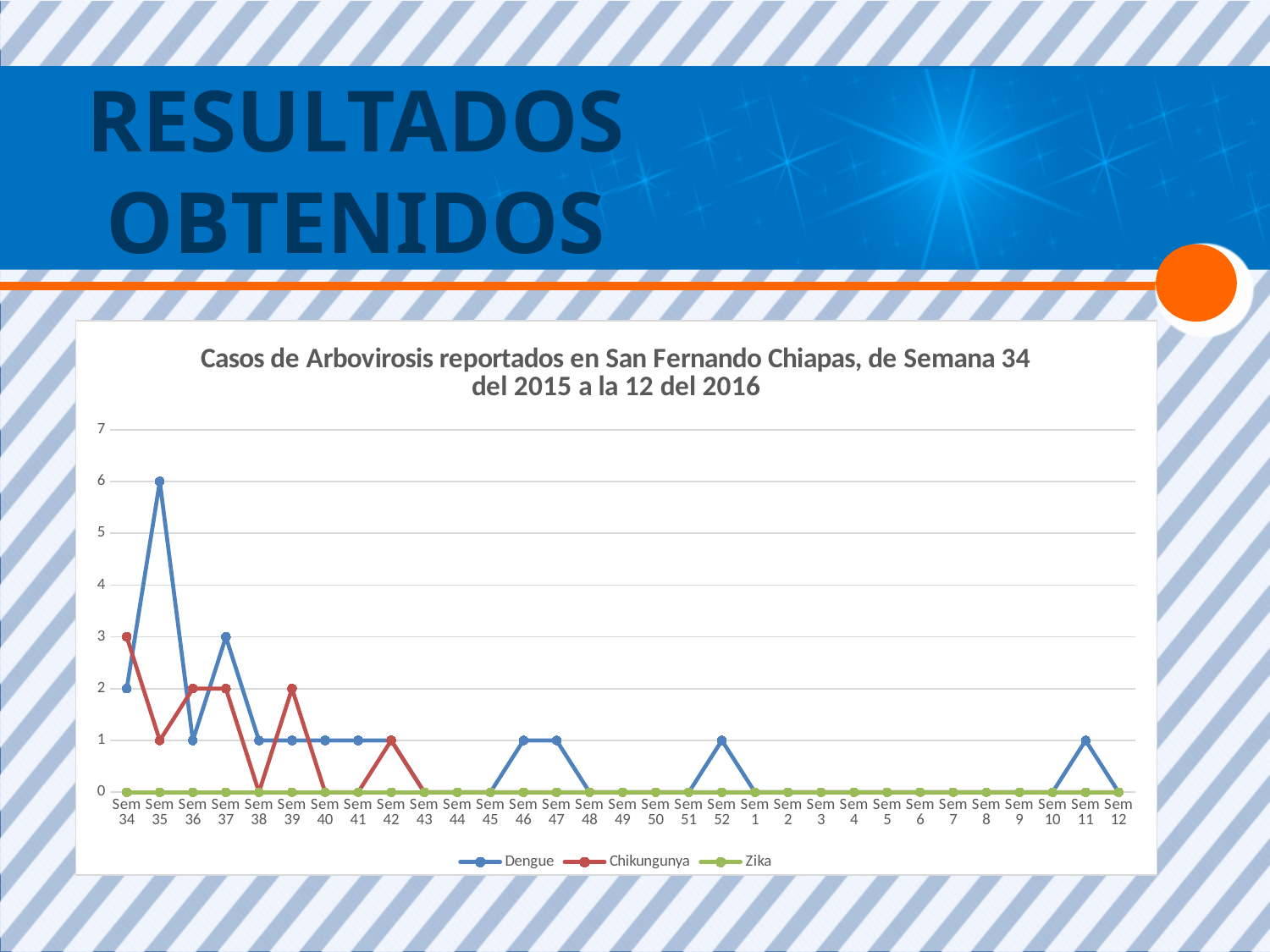
What is the Dengue value at Sem 35? 6 How many weeks (categories) are plotted along the x axis? 31 Is the Dengue value at Sem 35 greater or less than 5? greater How many series does the legend list? 3 What is the Dengue value at Sem 37? 3 What kind of chart is shown on the slide? line chart In which week does Dengue reach its highest value? Sem 35 At Sem 34, which series has the larger value, Dengue or Chikungunya? Chikungunya What is the Zika value at Sem 12? 0 What is the title of the chart? Casos de Arbovirosis reportados en San Fernando Chiapas, de Semana 34 del 2015 a la 12 del 2016 What is the difference between the Dengue value at Sem 35 and the Dengue value at Sem 34? 4 What is the Chikungunya value at Sem 34? 3